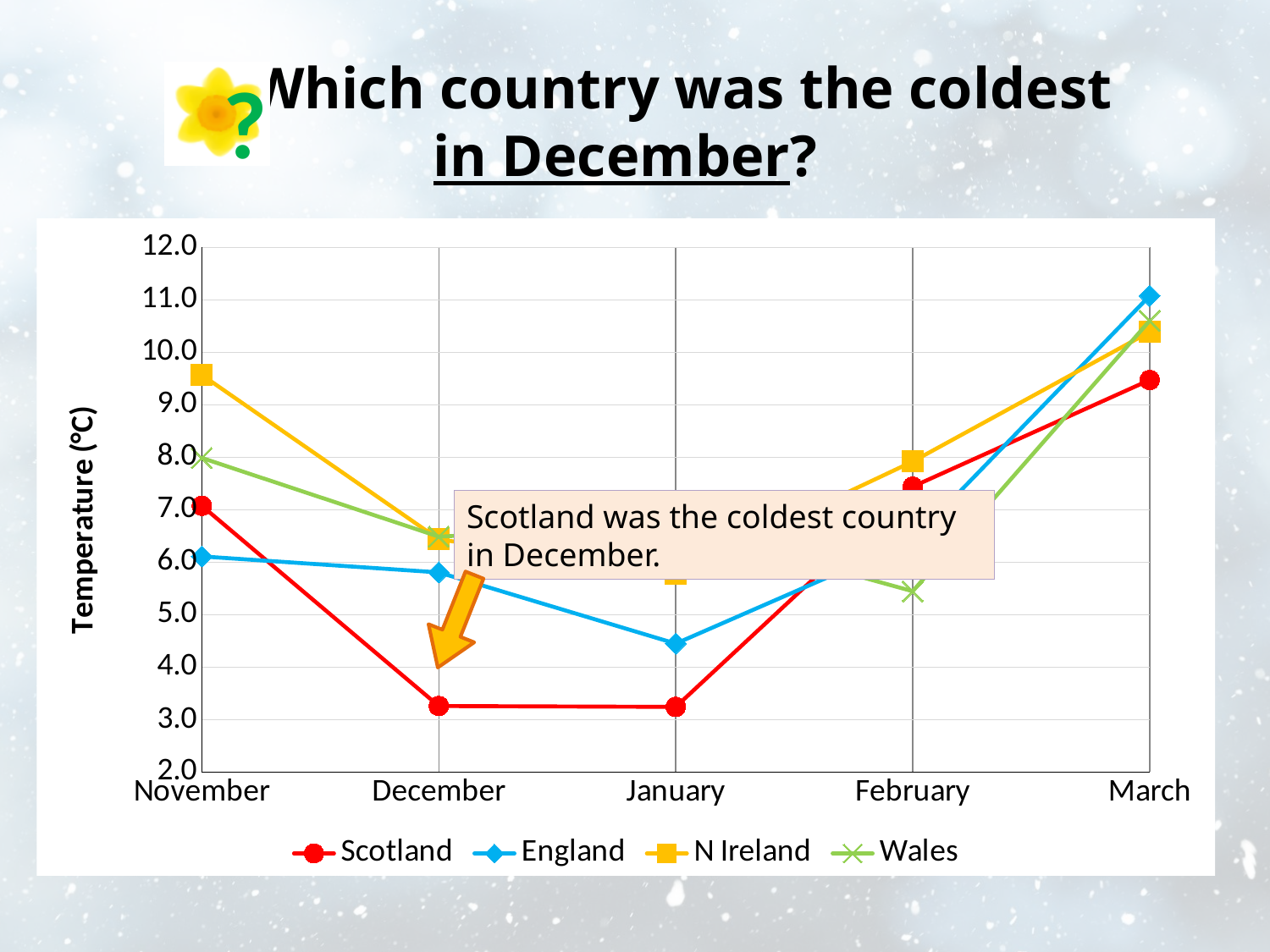
Is the value for N Ireland in November greater or less than 9.0? greater Is the value for England in March greater or less than 10.0? greater Does the Scotland line rise or fall from November to December? fall What kind of chart is shown on the slide? line chart Which country had the lowest temperature in December? Scotland What is the title of the vertical axis? Temperature (°C) How many series does the legend list? 4 Which country had the highest temperature in March? England How many months are shown on the x axis? 5 In November, which is larger: the value for Scotland or the value for England? Scotland Which country had the highest temperature in November? N Ireland Is the value for Scotland in December greater or less than 4.0? less